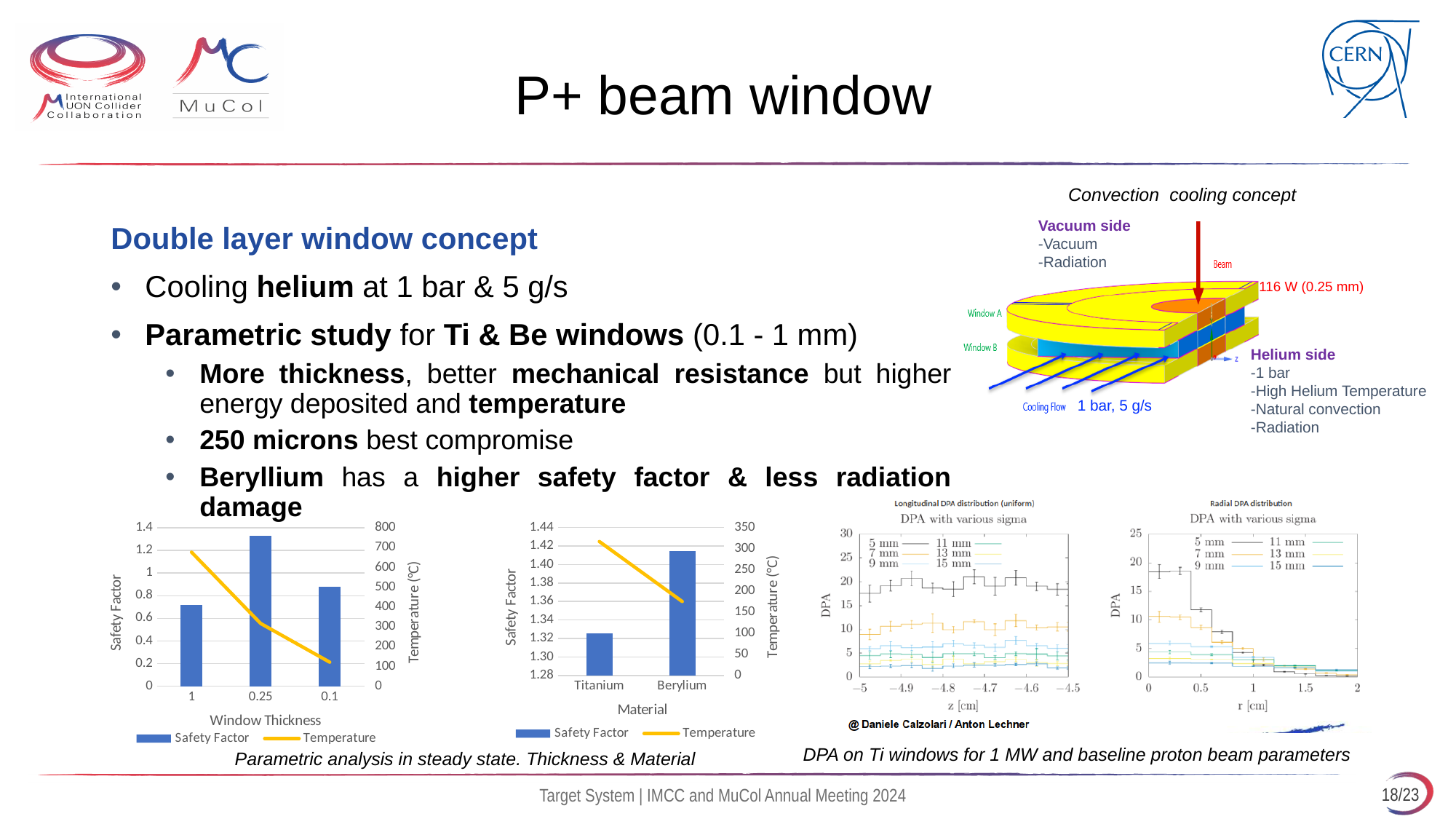
How many series does the legend of the Window Thickness chart list? 2 In the Window Thickness chart, which window thickness has the lowest safety factor? 1 In the Window Thickness chart, does the temperature rise or fall going from thickness 1 to 0.1 along the x axis? fall In the Material chart, which material has the higher safety factor, Titanium or Beryllium? Beryllium What kind of chart is used for the Safety Factor series in the Material chart? bar chart In the Window Thickness chart, which window thickness has the highest safety factor? 0.25 In the Material chart, is the temperature for Titanium greater or less than 250? greater In the Material chart, is the safety factor for Titanium greater or less than 1.34? less How many window thickness categories are shown in the Window Thickness chart? 3 In the Window Thickness chart, is the safety factor for thickness 0.25 greater or less than 1.2? greater How many series does the legend of the Radial DPA distribution chart list? 6